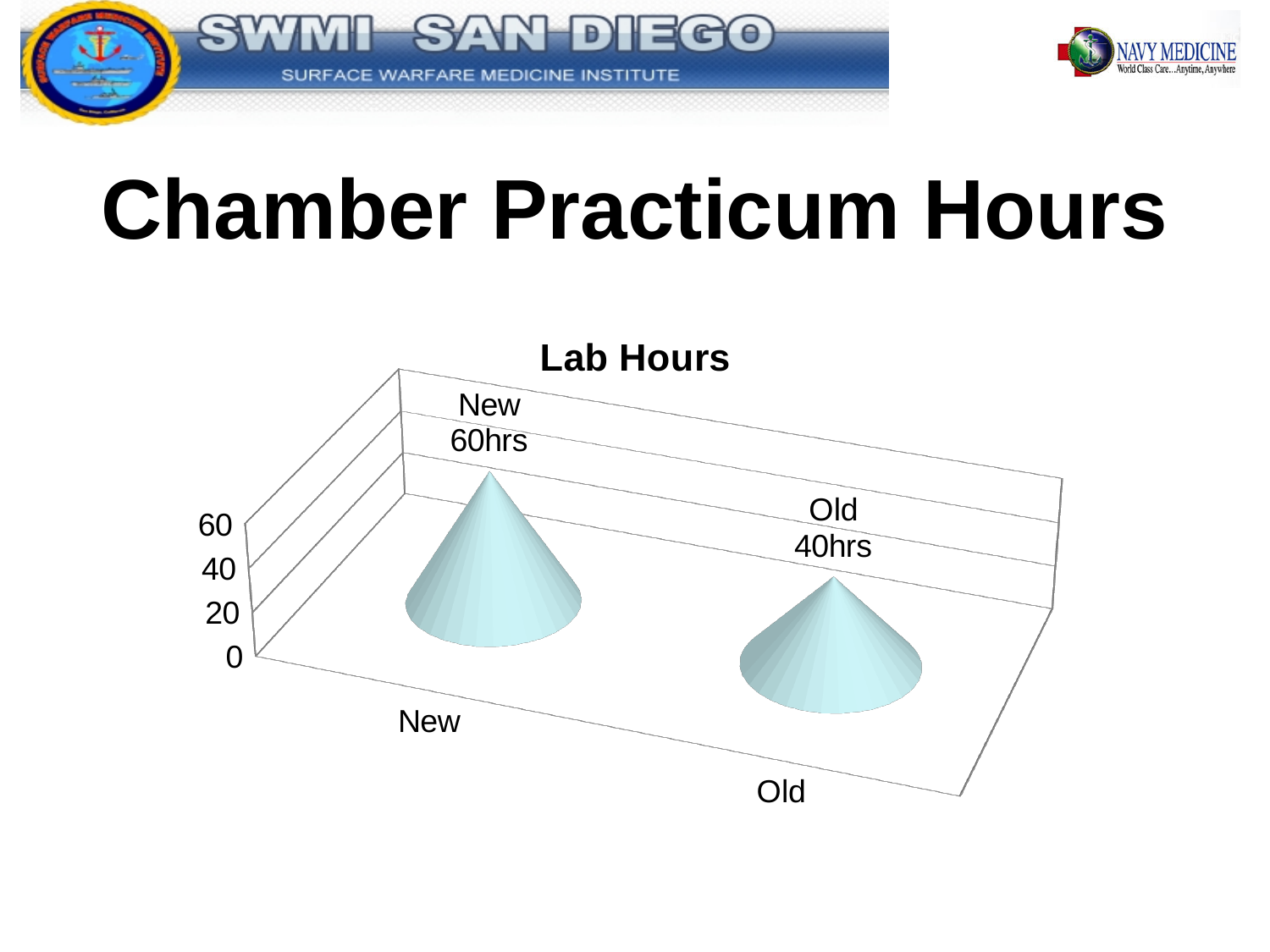
What is the title of the chart on the slide? Lab Hours Do the values fall or rise going from New to Old in the Lab Hours chart? fall How many categories are shown in the Lab Hours chart? 2 Which is larger in the Lab Hours chart, New or Old? New What is the value for Old in the Lab Hours chart? 40hrs What is the highest value shown on the vertical axis of the Lab Hours chart? 60 What is the value for New in the Lab Hours chart? 60hrs Which category has the highest value in the Lab Hours chart? New Is the value for Old greater or less than 60 in the Lab Hours chart? less Which category has the lowest value in the Lab Hours chart? Old What is the difference in hours between New and Old in the Lab Hours chart? 20hrs Is the value for New greater or less than 40 in the Lab Hours chart? greater